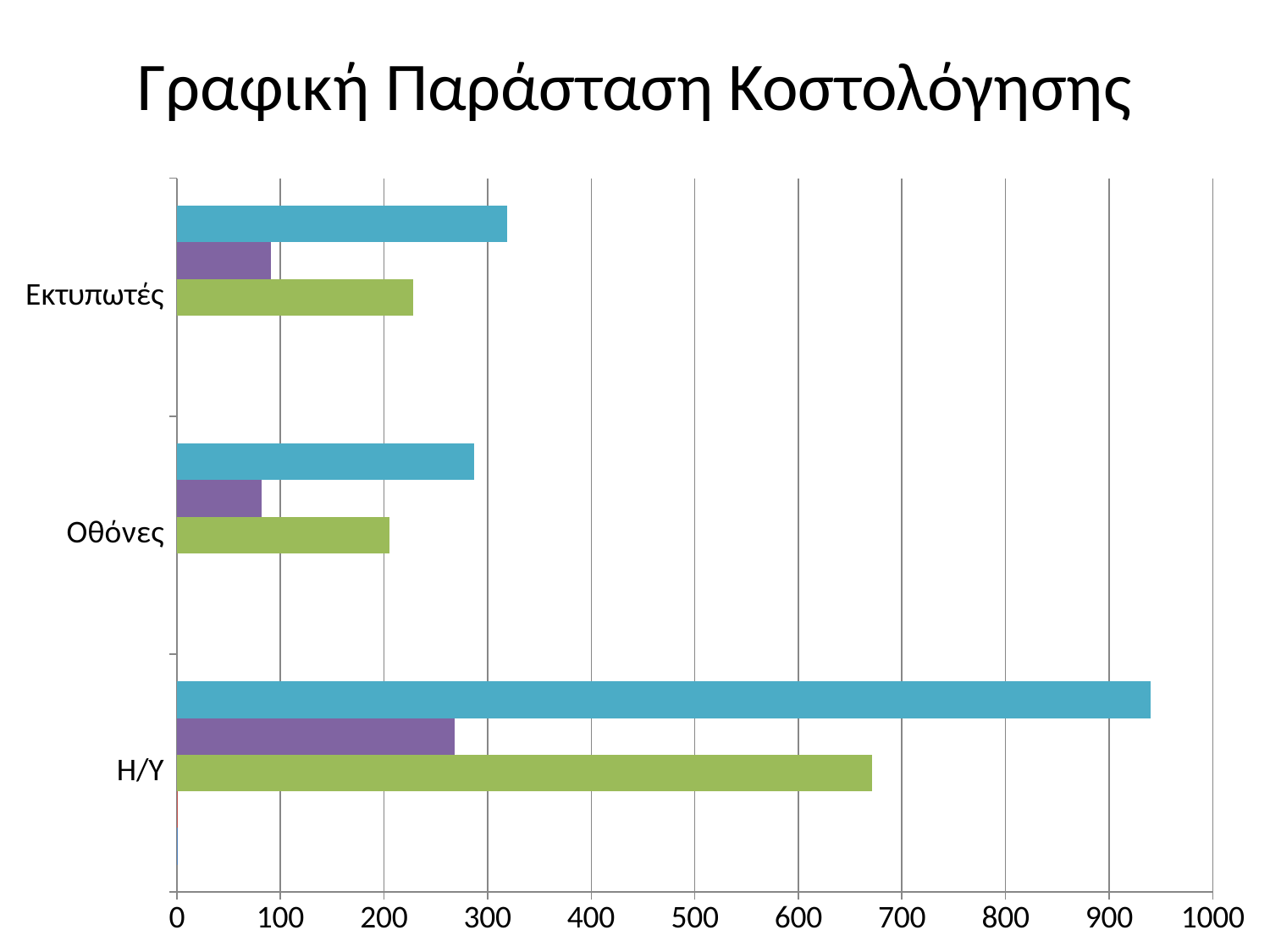
How many categories are shown on the vertical axis of the chart? 3 Is the value of the purple bar for Εκτυπωτές greater or less than 100? less Which is larger: the blue bar for Εκτυπωτές or the blue bar for Οθόνες? Εκτυπωτές Which is larger: the purple bar for Η/Υ or the purple bar for Οθόνες? Η/Υ How many bars are plotted for each category in the chart? 3 Which category has the longest bar in the chart? Η/Υ What kind of chart is shown on the slide? bar chart Is the value of the blue bar for Η/Υ greater or less than 900? greater What is the title of the chart slide? Γραφική Παράσταση Κοστολόγησης Is the value of the blue bar for Οθόνες greater or less than 300? less